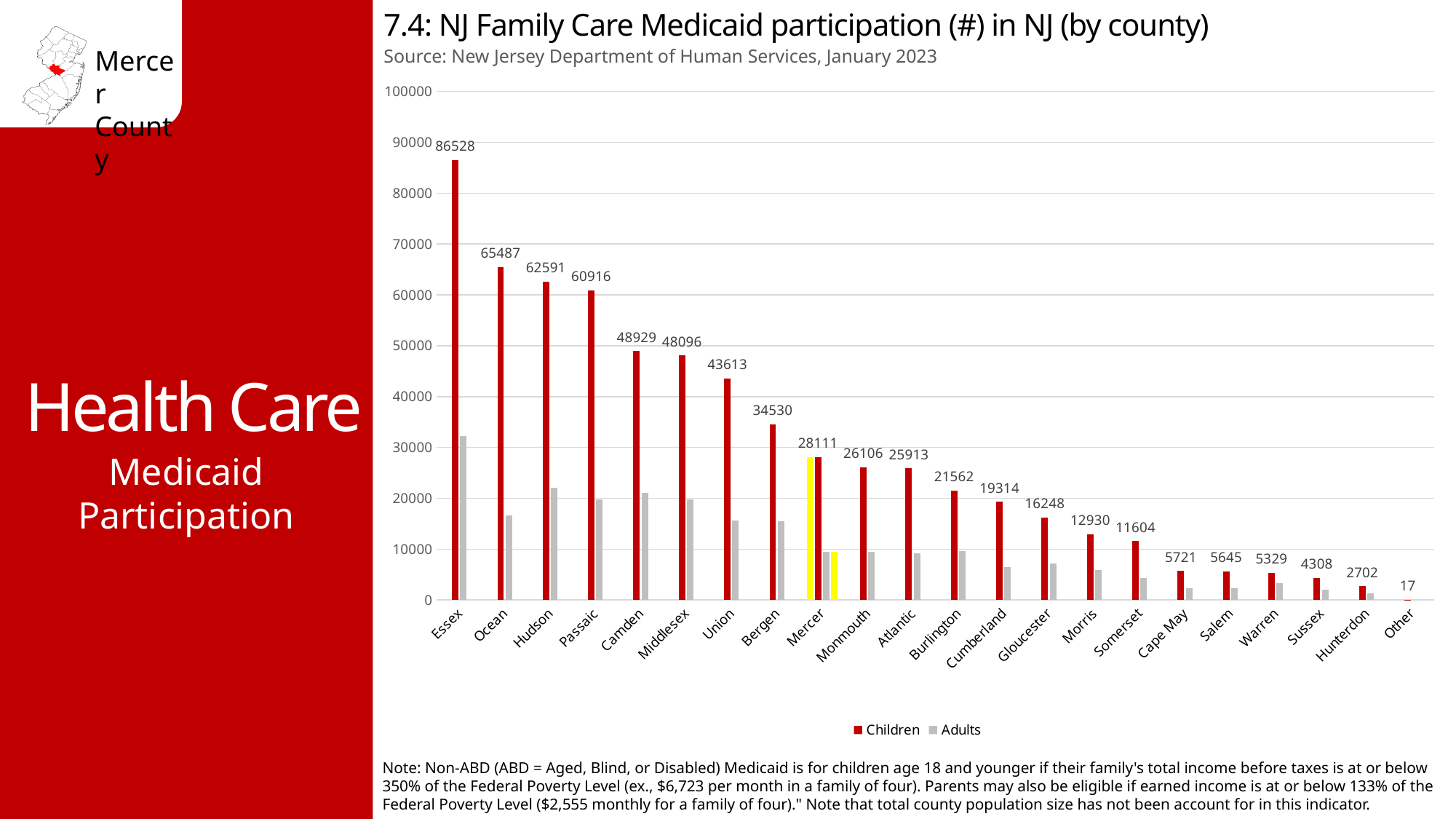
Is the Adults value for Essex greater or less than 30000? greater Which county has the highest Children value? Essex How many series does the legend list? 2 Which has a larger Children value, Camden or Union? Camden What is the difference between the Children values for Essex and Ocean? 21041 How many categories are shown on the x axis? 22 What is the Children value for Essex? 86528 What kind of chart is shown? bar chart What is the Children value for Hunterdon? 2702 Which category has the lowest Children value? Other What is the Children value for Mercer? 28111